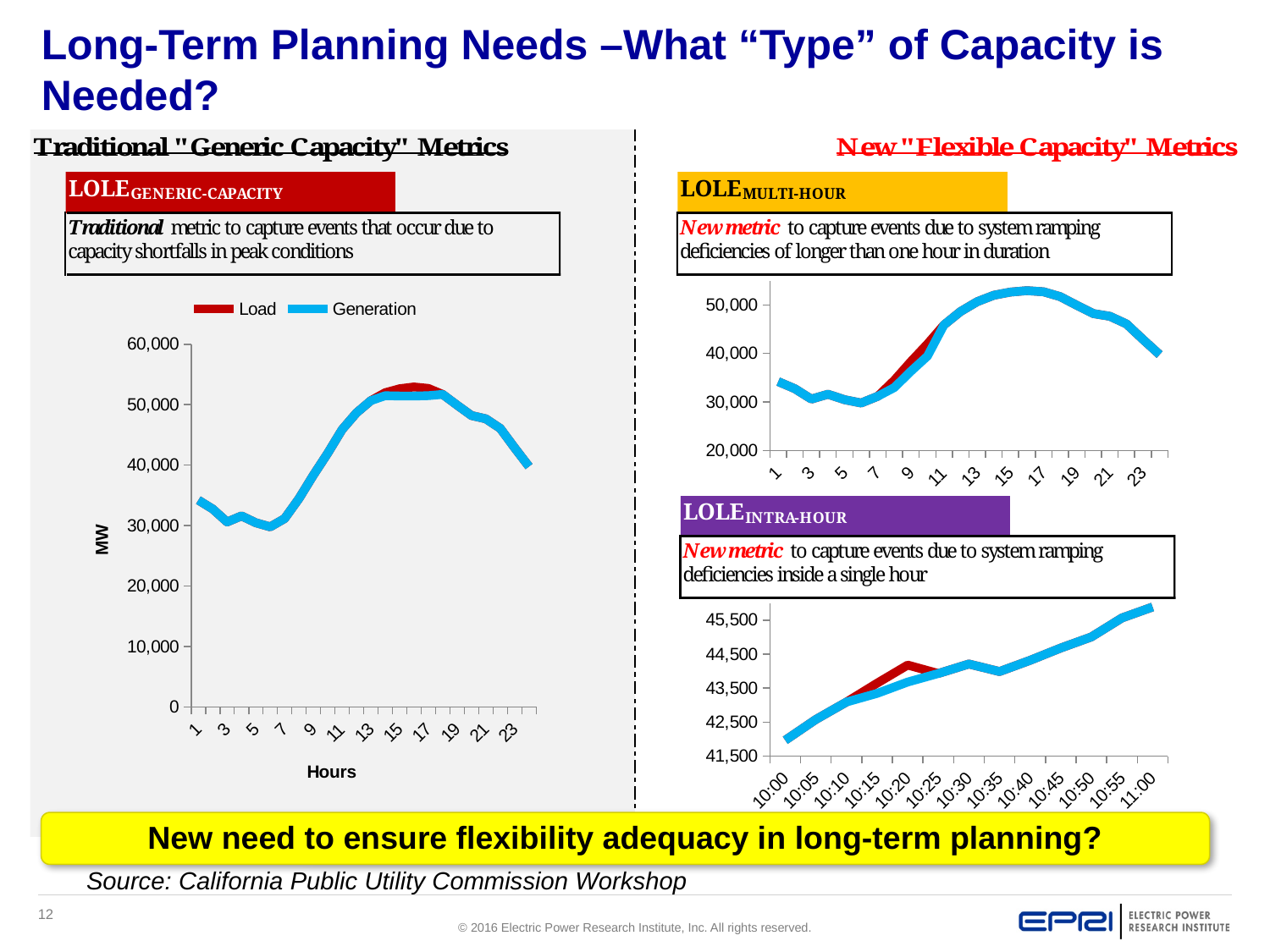
In the left chart, what are the two series named in the legend? Load and Generation What kind of chart is the left chart under "Traditional 'Generic Capacity' Metrics"? line chart In the top-right chart (LOLE multi-hour), is the value at hour 5 greater or less than 40,000? less In the bottom-right chart (LOLE intra-hour), is the value at 10:00 greater or less than 42,500? less In the left chart, how many series does the legend list? 2 In the left chart, which is larger, the Generation value at hour 15 or at hour 5? hour 15 In the bottom-right chart (LOLE intra-hour), do the values generally rise or fall from 10:00 to 11:00? rise In the bottom-right chart (LOLE intra-hour), how many time labels are shown on the x axis? 13 In the left chart, is the Load value at hour 15 greater or less than 50,000? greater In the left chart, what is the label on the y axis? MW In the top-right chart (LOLE multi-hour), do the values rise or fall from hour 17 to hour 23? fall